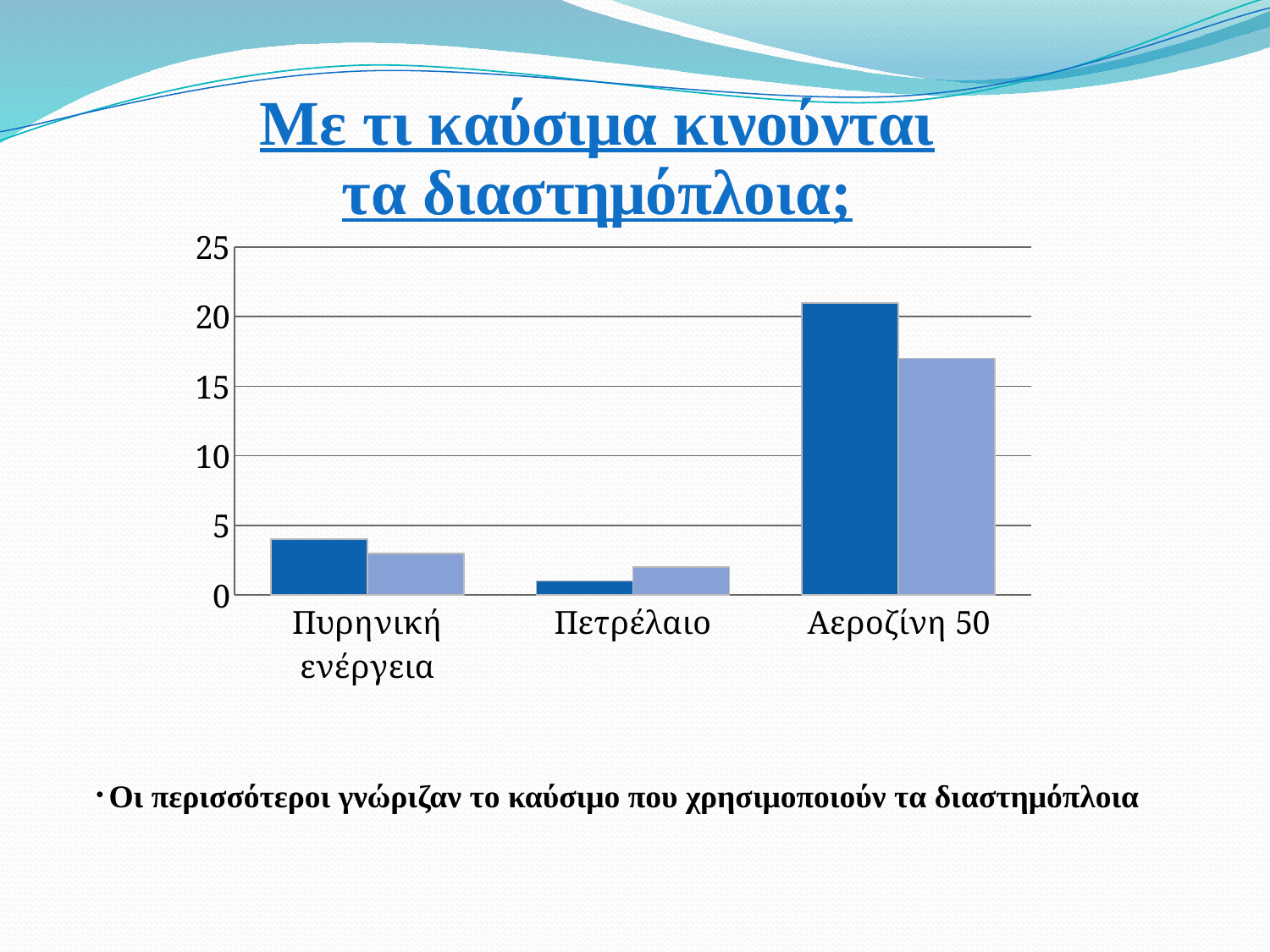
Is the dark blue bar for Πυρηνική ενέργεια greater or less than 5? less For Αεροζίνη 50, which bar is taller: the dark blue or the light blue? dark blue How many categories are shown on the x axis of the chart? 3 What kind of chart is shown on the slide? bar chart Which category has the lowest dark blue bar? Πετρέλαιο Which category has the highest light blue bar? Αεροζίνη 50 Is the dark blue bar for Αεροζίνη 50 greater or less than 20? greater For the dark blue bars, which is larger: Πυρηνική ενέργεια or Πετρέλαιο? Πυρηνική ενέργεια Which category has the highest dark blue bar? Αεροζίνη 50 Is the light blue bar for Αεροζίνη 50 greater or less than 20? less What is the title of the slide containing the chart? Με τι καύσιμα κινούνται τα διαστημόπλοια;